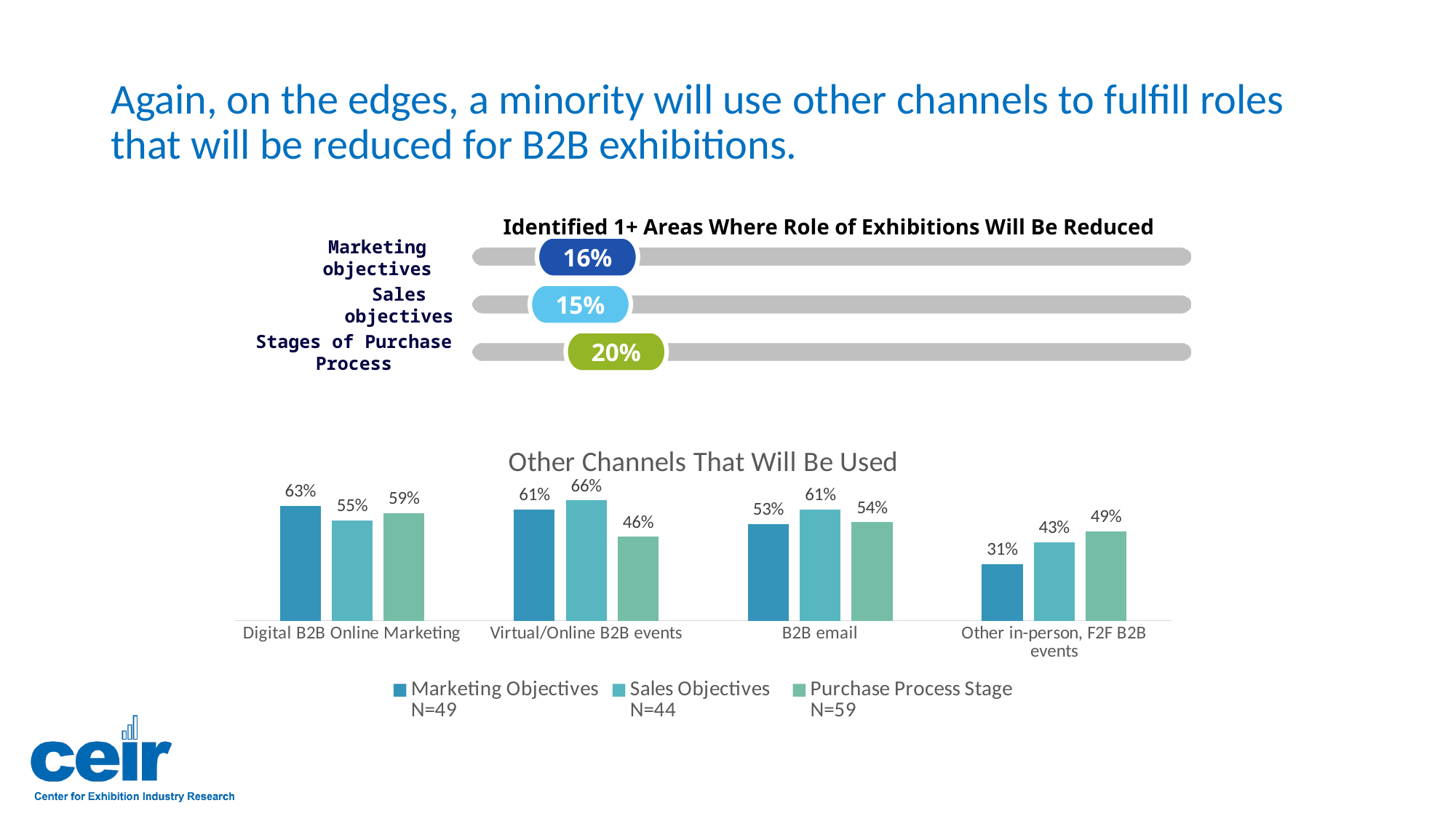
In the 'Other Channels That Will Be Used' chart, what is the Marketing Objectives value for Digital B2B Online Marketing? 63% In the 'Other Channels That Will Be Used' chart, what is the Purchase Process Stage value for Other in-person, F2F B2B events? 49% In the 'Other Channels That Will Be Used' chart, which is larger for B2B email: Marketing Objectives or Sales Objectives? Sales Objectives In the 'Identified 1+ Areas Where Role of Exhibitions Will Be Reduced' chart, which category has the highest value? Stages of Purchase Process In the 'Other Channels That Will Be Used' chart, which channel has the lowest Marketing Objectives value? Other in-person, F2F B2B events In the 'Other Channels That Will Be Used' chart, what is the difference between the Sales Objectives and Purchase Process Stage values for Virtual/Online B2B events? 20% How many series does the legend of the 'Other Channels That Will Be Used' chart list? 3 In the 'Other Channels That Will Be Used' chart, what is the N for the Purchase Process Stage series shown in the legend? N=59 In the 'Other Channels That Will Be Used' chart, what is the Sales Objectives value for Virtual/Online B2B events? 66% What kind of chart is 'Other Channels That Will Be Used'? Bar chart How many channel categories are shown in the 'Other Channels That Will Be Used' chart? 4 In the 'Identified 1+ Areas Where Role of Exhibitions Will Be Reduced' chart, what is the value for Sales objectives? 15%